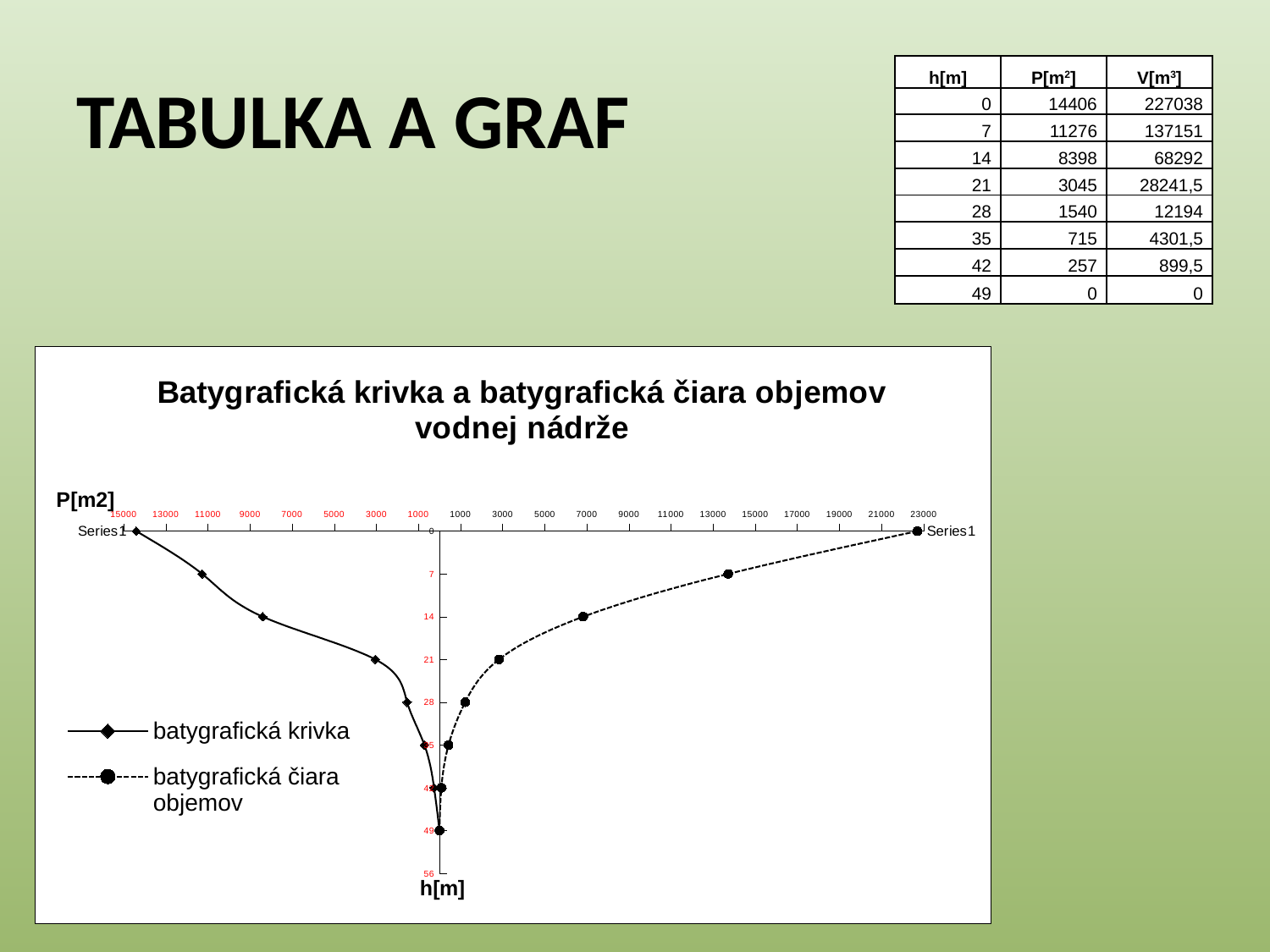
Is the value of the batygrafická čiara objemov series at h = 0 greater or less than 21000? greater How many data points are plotted for the batygrafická krivka series? 8 As h[m] increases from 0 to 49, do the values of the batygrafická krivka series rise or fall? fall How many series does the chart legend list? 2 Is the value of the batygrafická krivka series at h = 14 greater or less than 9000? less What are the two series named in the chart legend? batygrafická krivka; batygrafická čiara objemov Which series is drawn with a dashed line and circle markers? batygrafická čiara objemov What type of chart is shown on the slide? line chart Is the value of the batygrafická krivka series at h = 0 greater or less than 13000? greater What is the title of the chart? Batygrafická krivka a batygrafická čiara objemov vodnej nádrže